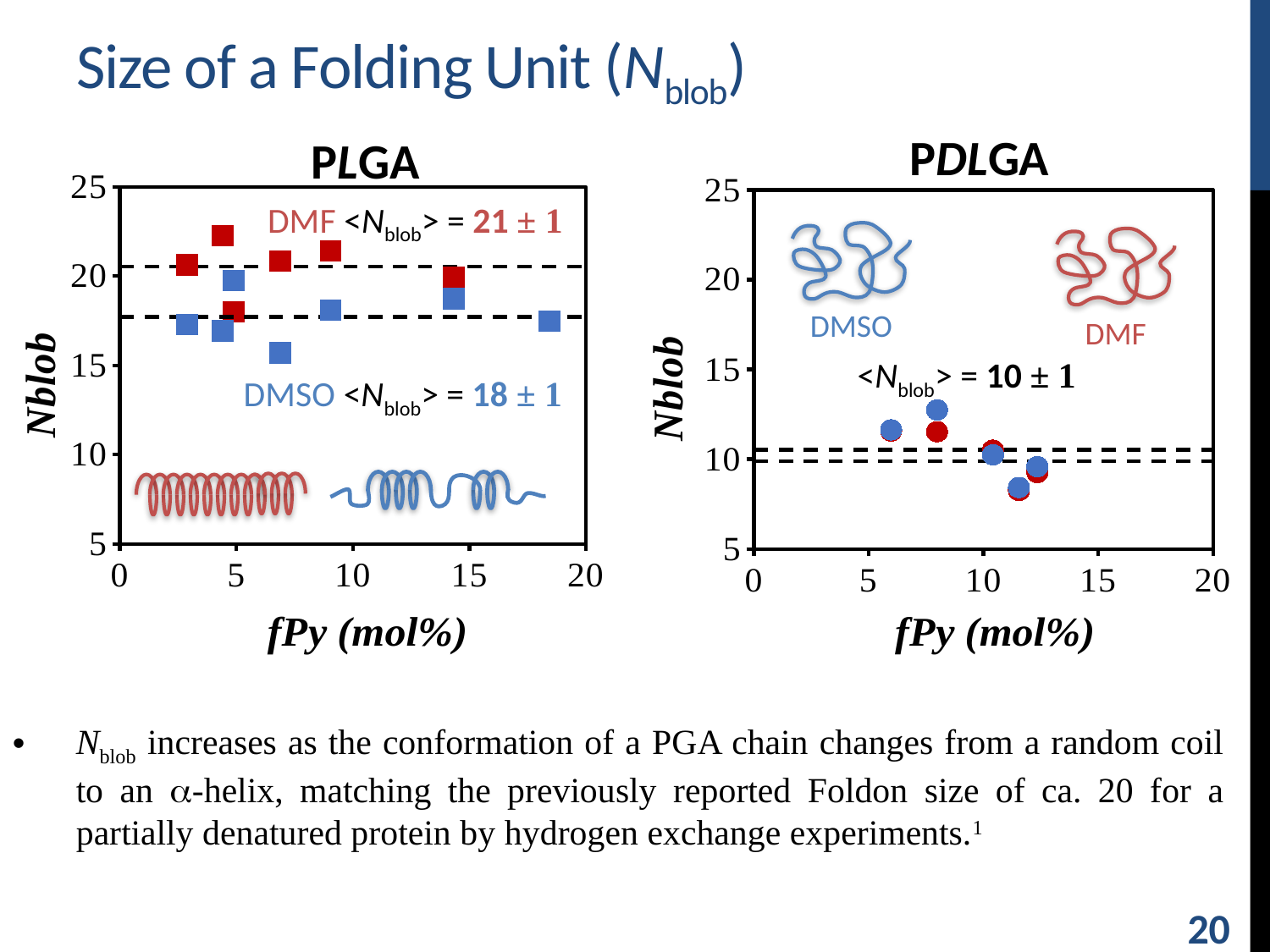
How many charts are shown on the slide? 2 What is the maximum value shown on the y axis of the PDLGA chart? 25 Which chart reports the lower average <Nblob>, PLGA or PDLGA? PDLGA In the PLGA chart, which solvent has the higher average <Nblob>, DMF or DMSO? DMF In the PLGA chart, is the highest red DMF point greater or less than 20? greater In the PLGA chart, what is the average <Nblob> reported for DMSO? 18 ± 1 In the PDLGA chart, are all the plotted Nblob values greater or less than 15? less What kind of chart is the PLGA chart on the left? scatter chart In the PLGA chart, what is the difference between the DMF and DMSO average <Nblob> values? 3 What is the label of the x axis on both charts? fPy (mol%) In the PDLGA chart, what is the average <Nblob> reported? 10 ± 1 In the PLGA chart, what is the average <Nblob> reported for DMF? 21 ± 1